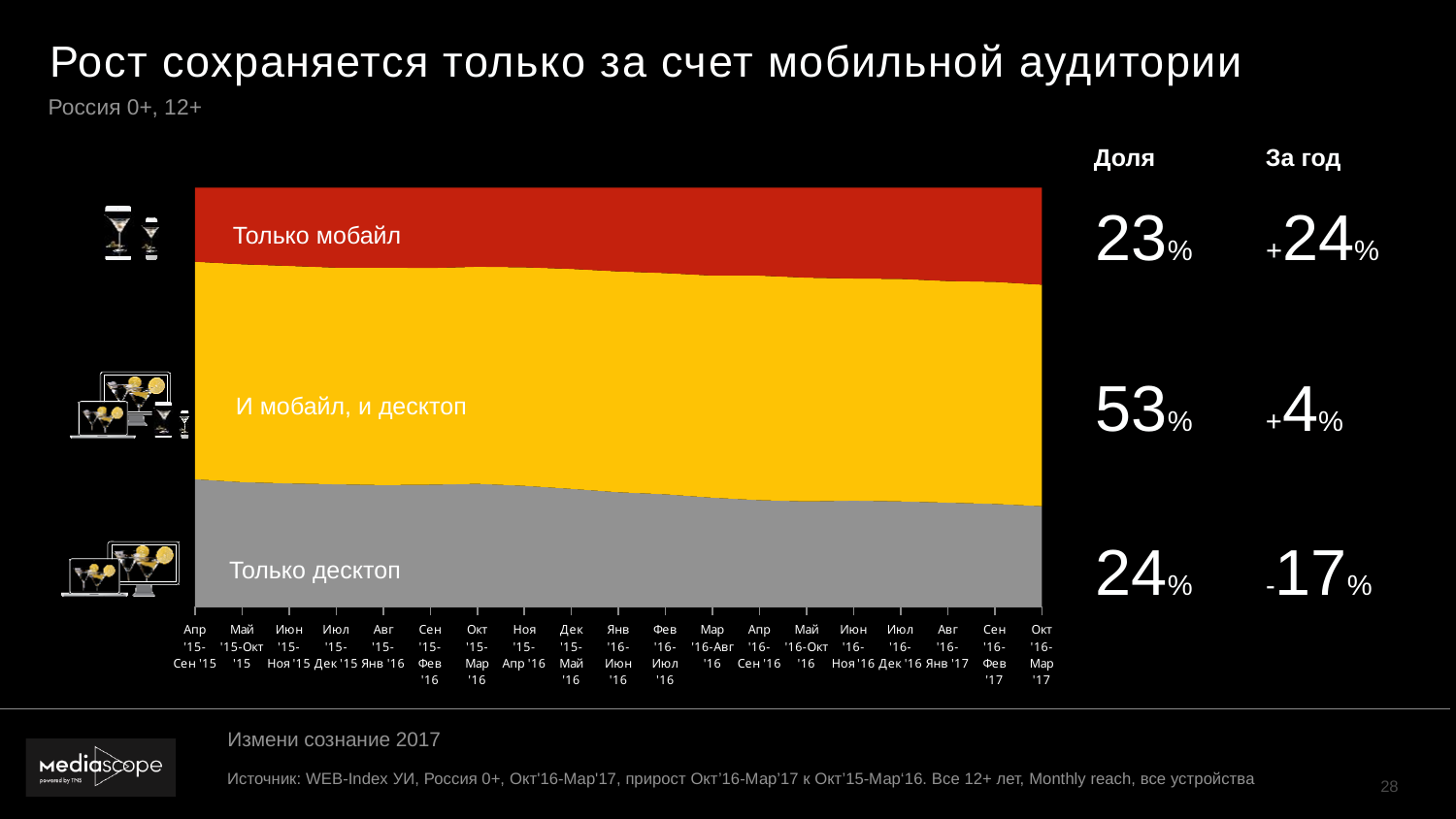
Which segment has the largest share (Доля)? И мобайл, и десктоп What is the share (Доля) for 'И мобайл, и десктоп'? 53% What is the difference in share between 'И мобайл, и десктоп' and 'Только десктоп'? 29 percentage points What is the year-over-year change (За год) for 'Только десктоп'? -17% What kind of chart is shown on the slide? stacked area chart What is the share (Доля) for 'Только десктоп'? 24% How many time periods are shown on the x axis? 19 What is the year-over-year change (За год) for 'Только мобайл'? +24% Does the 'Только мобайл' segment grow or shrink over the periods shown on the x axis? grows How many series (segments) are shown in the stacked area chart? 3 What is the share (Доля) for 'Только мобайл'? 23% Which segment has the smallest share (Доля)? Только мобайл